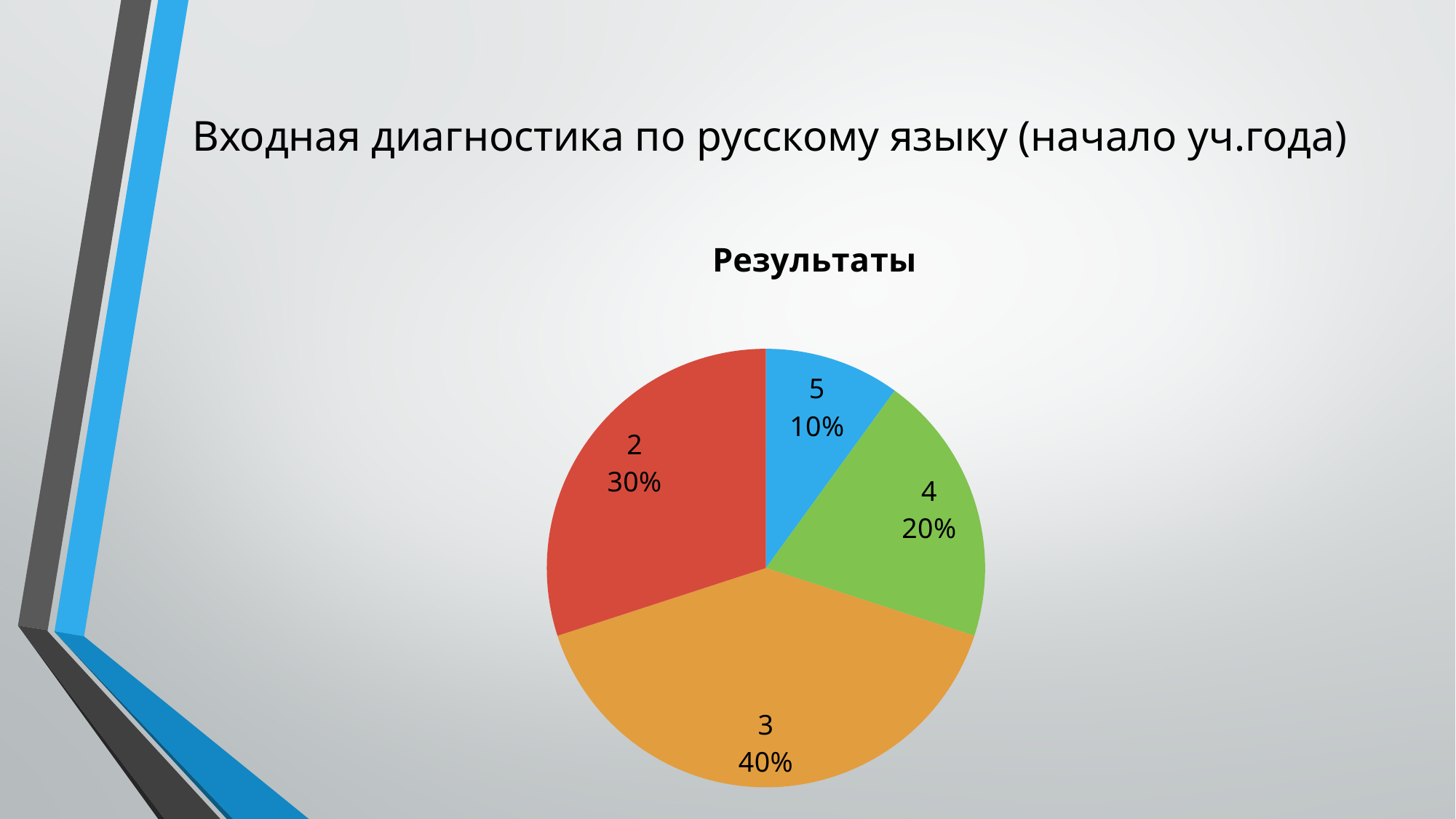
Which slice is the largest? 3 What share of the pie does the slice labelled 2 take? 30% What share of the pie does the slice labelled 4 take? 20% Which slice is the smallest? 5 How many slices does the pie chart have? 4 What colour is the slice labelled 3? orange What is the title of the chart? Результаты What is the difference between the shares of slices 3 and 5? 30% What share of the pie does the slice labelled 5 take? 10% What kind of chart is shown on the slide? pie chart Which slice is larger, 2 or 4? 2